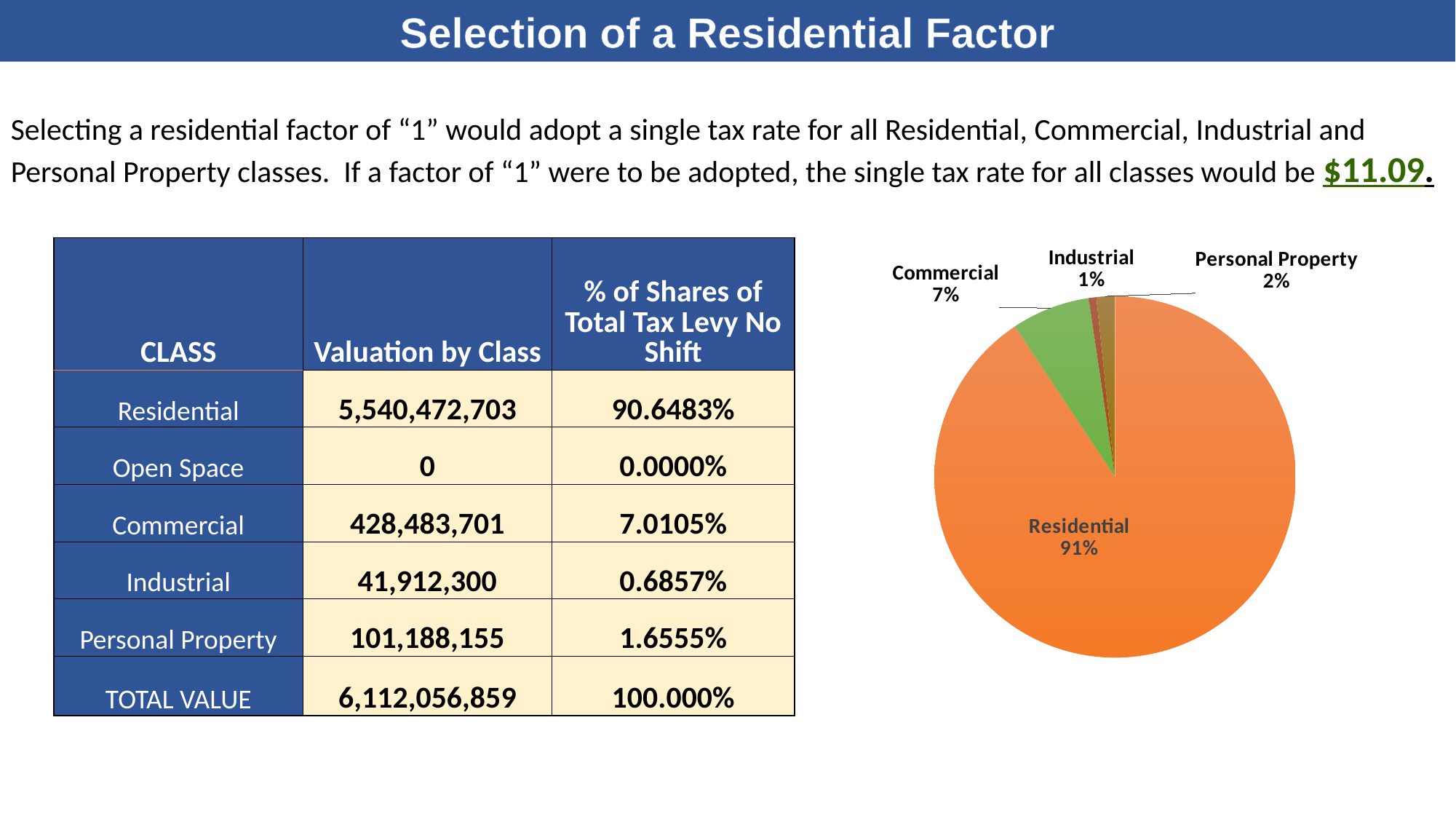
How many labelled slices does the pie chart have? 4 What share of the pie chart does Personal Property have? 2% Which slice of the pie chart is the largest? Residential What share of the pie chart does Residential have? 91% What share of the pie chart does Industrial have? 1% In the pie chart, which is larger, Commercial or Personal Property? Commercial What colour is the Residential slice of the pie chart? orange Which slice of the pie chart is the smallest? Industrial What is the difference in percentage points between the Personal Property and Industrial slices of the pie chart? 1 What kind of chart is shown on the slide? pie chart What is the difference in percentage points between the Residential and Commercial slices of the pie chart? 84 What share of the pie chart does Commercial have? 7%